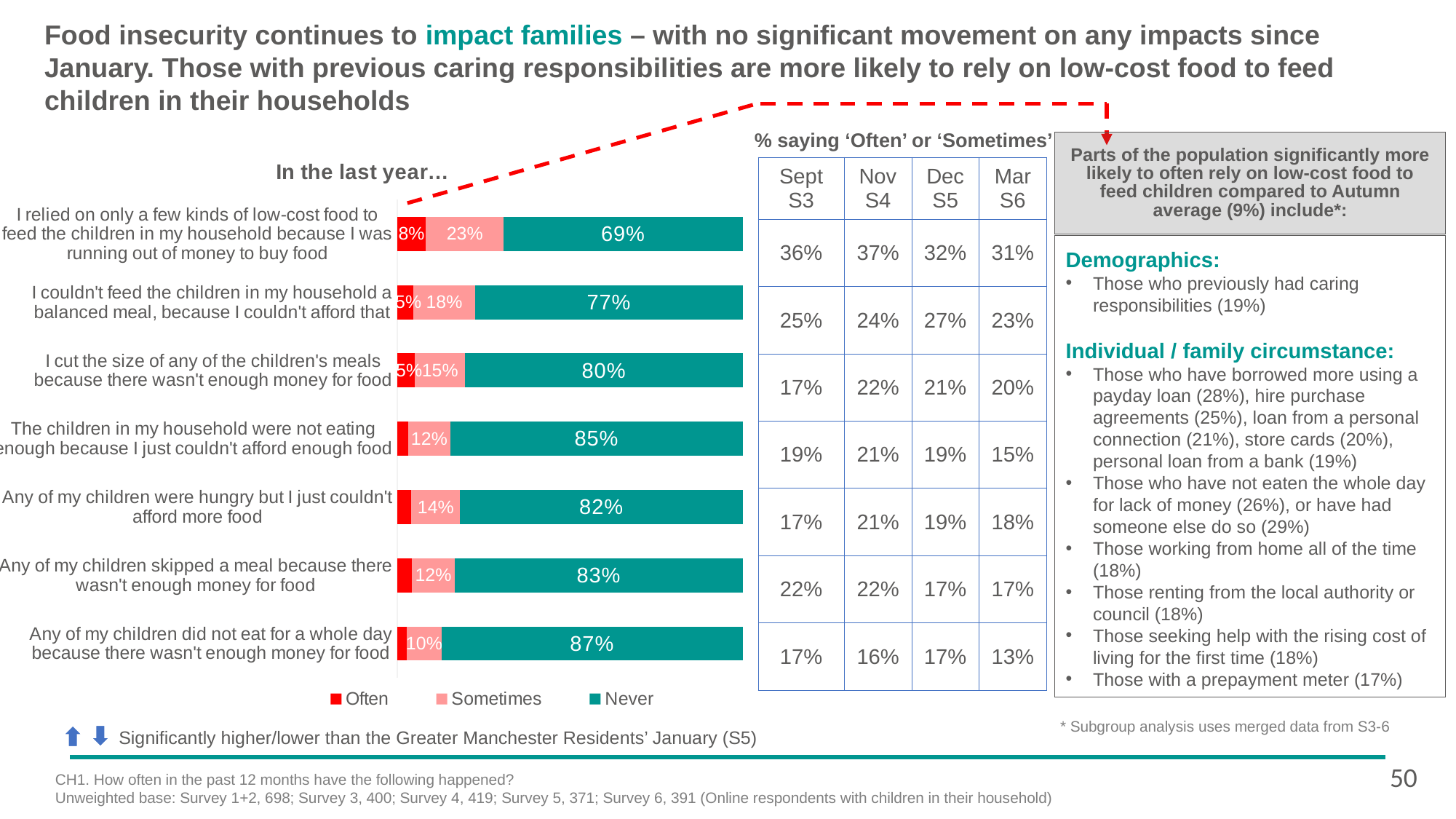
Which is larger: the 'Sometimes' value for 'Any of my children were hungry but I just couldn't afford more food' or for 'Any of my children skipped a meal because there wasn't enough money for food'? Any of my children were hungry but I just couldn't afford more food How many categories (statements) are plotted in the bar chart? 7 Which statement has the lowest 'Never' value? I relied on only a few kinds of low-cost food to feed the children in my household because I was running out of money to buy food What is the 'Often' value for 'I relied on only a few kinds of low-cost food to feed the children in my household because I was running out of money to buy food'? 8% Which colour represents the 'Never' series in the chart? Teal What is the 'Sometimes' value for 'I couldn't feed the children in my household a balanced meal, because I couldn't afford that'? 18% What is the difference between the 'Never' values for 'I cut the size of any of the children's meals because there wasn't enough money for food' and 'I couldn't feed the children in my household a balanced meal, because I couldn't afford that'? 3% What is the 'Never' value for 'I relied on only a few kinds of low-cost food to feed the children in my household because I was running out of money to buy food'? 69% What is the 'Never' value for 'Any of my children did not eat for a whole day because there wasn't enough money for food'? 87% How many series does the chart legend list? 3 Which statement has the highest 'Never' value? Any of my children did not eat for a whole day because there wasn't enough money for food What kind of chart is shown on the slide? Stacked bar chart